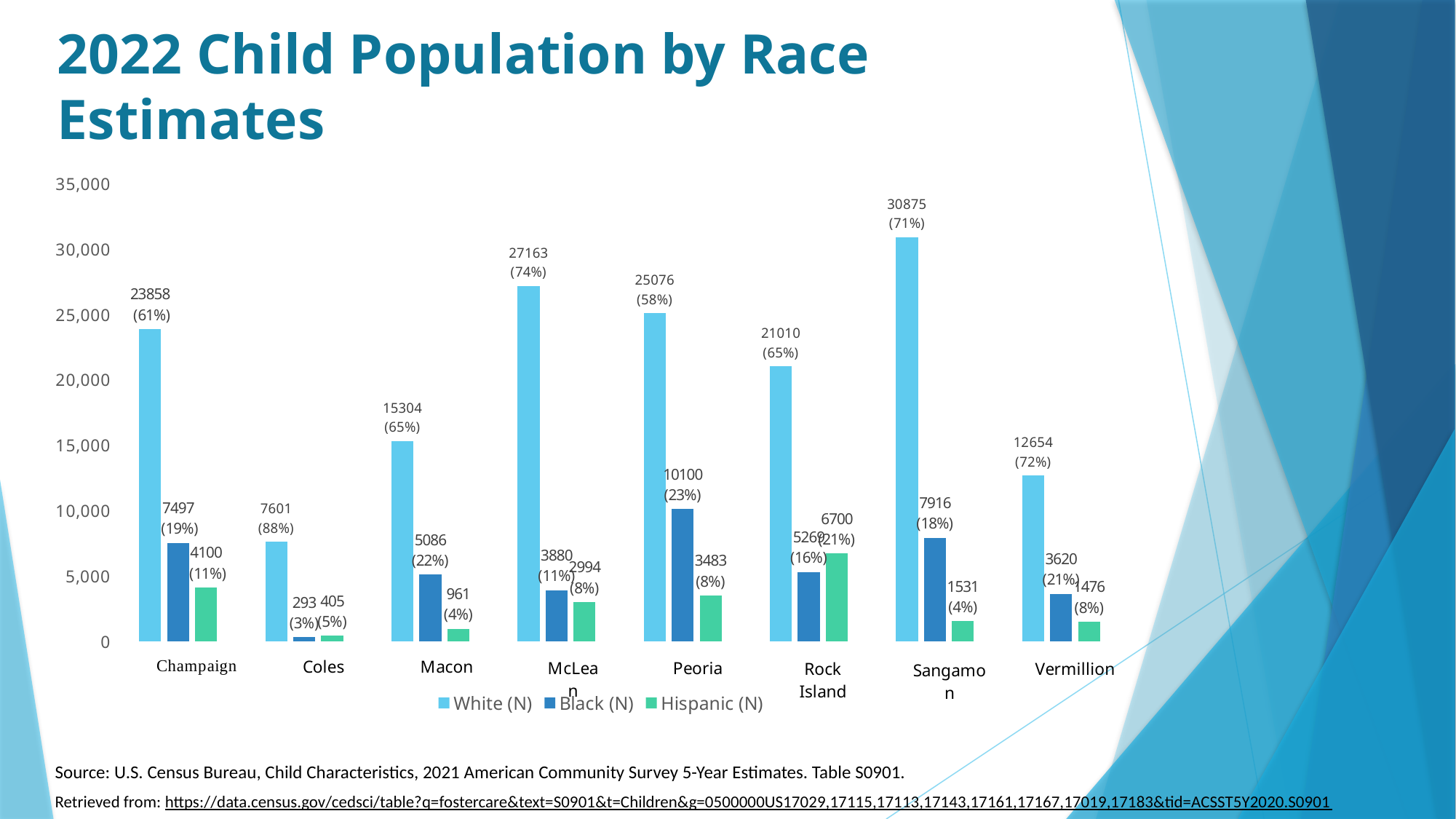
What is the Black (N) value for Peoria? 10100 What kind of chart is shown on the slide? bar chart What is the total of the three values shown for Coles? 8299 How many counties are shown on the x axis? 8 What is the White (N) value for Champaign? 23858 How many series does the legend list? 3 What percentage is shown next to the White (N) bar for Coles? 88% Which county has the highest White (N) value? Sangamon Is the White (N) value for Vermillion greater or less than 10,000? greater Which county has the lowest Black (N) value? Coles What is the difference between the White (N) values for Sangamon and McLean? 3712 Which is larger, the Hispanic (N) value for Rock Island or for Champaign? Rock Island